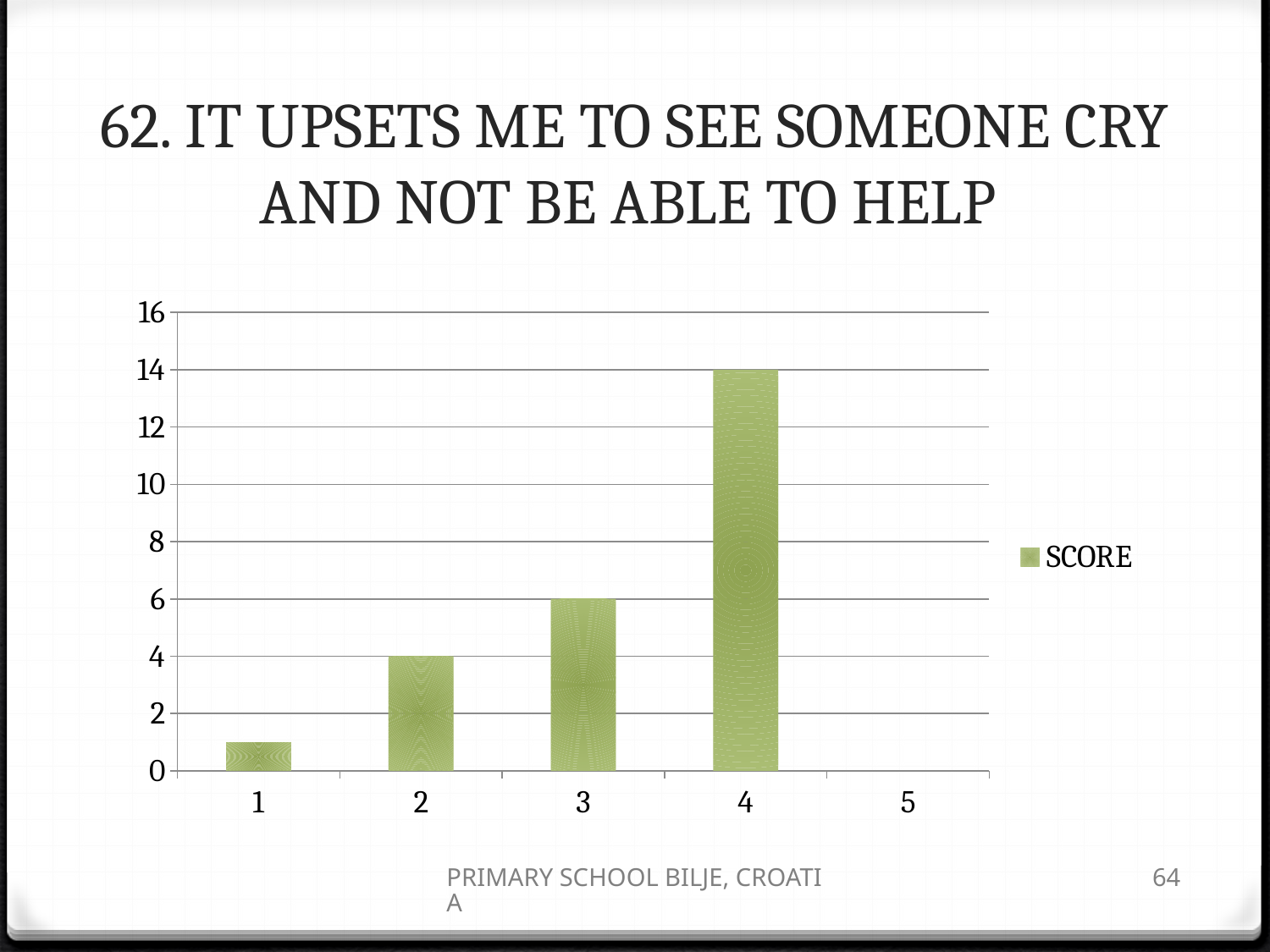
How many categories are shown on the x axis? 5 Is the value for category 1 greater or less than 2? less What is the value for category 3? 6 What is the value for category 5? 0 What is the difference between the values for category 4 and category 3? 8 What is the value for category 4? 14 What is the name of the series listed in the legend? SCORE What is the value for category 2? 4 Which has a larger value, category 2 or category 3? 3 Which category has the lowest value? 5 Which category has the highest value? 4 What kind of chart is shown on the slide? bar chart